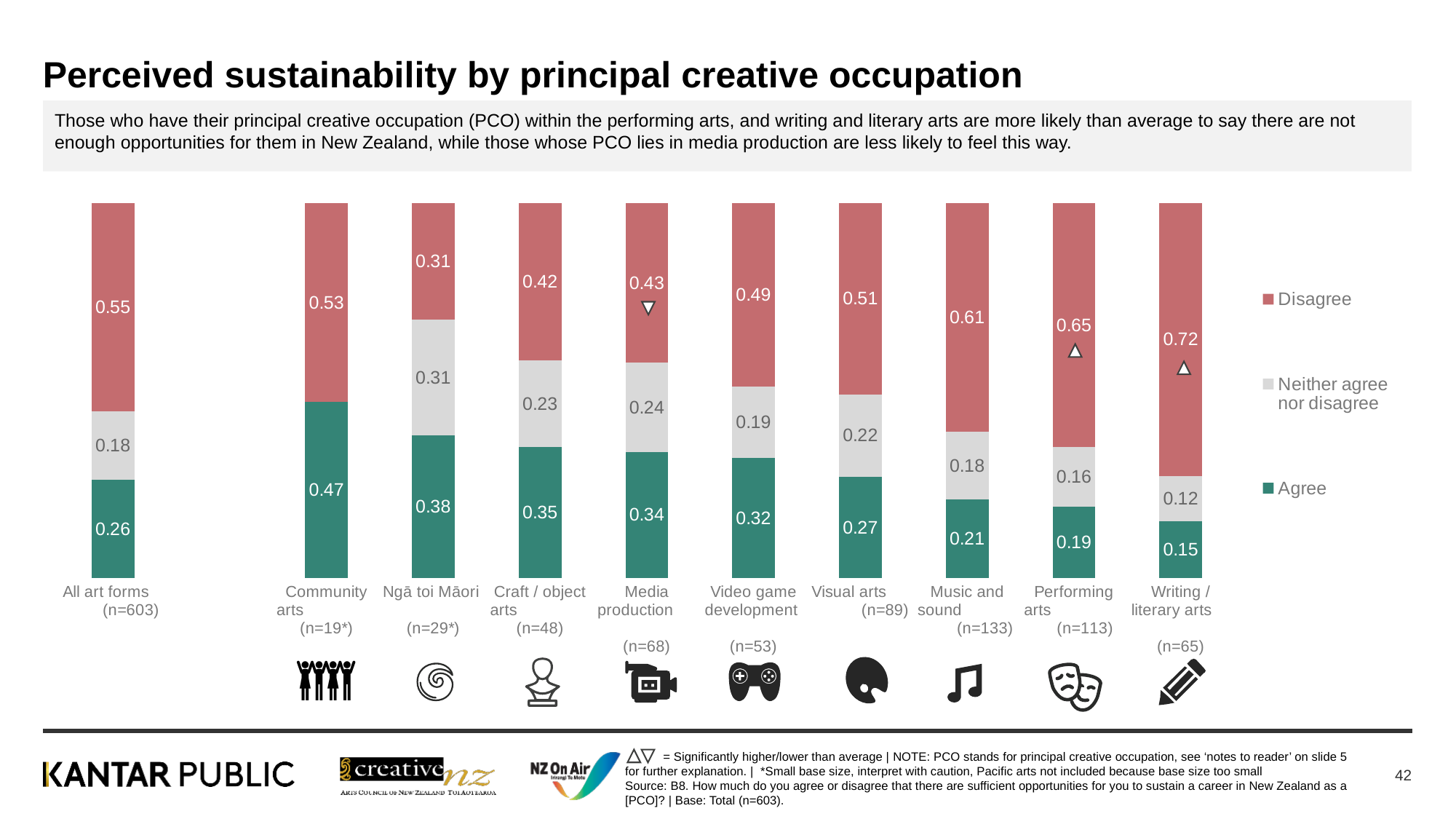
Which category has the lowest Agree value? Writing / literary arts Which category has the highest Agree value? Community arts What is the Agree value for Writing / literary arts? 0.15 Which is larger: the Agree value for Ngā toi Māori or the Agree value for Craft / object arts? Ngā toi Māori What kind of chart is shown on the slide? Stacked bar chart How many series does the legend list? 3 What is the Neither agree nor disagree value for Visual arts? 0.22 What is the sample size shown for Music and sound? n=133 What is the Disagree value for Media production? 0.43 What is the difference between the Disagree values for Performing arts and All art forms? 0.10 How many occupation categories are plotted on the chart? 10 Which category has the highest Disagree value? Writing / literary arts